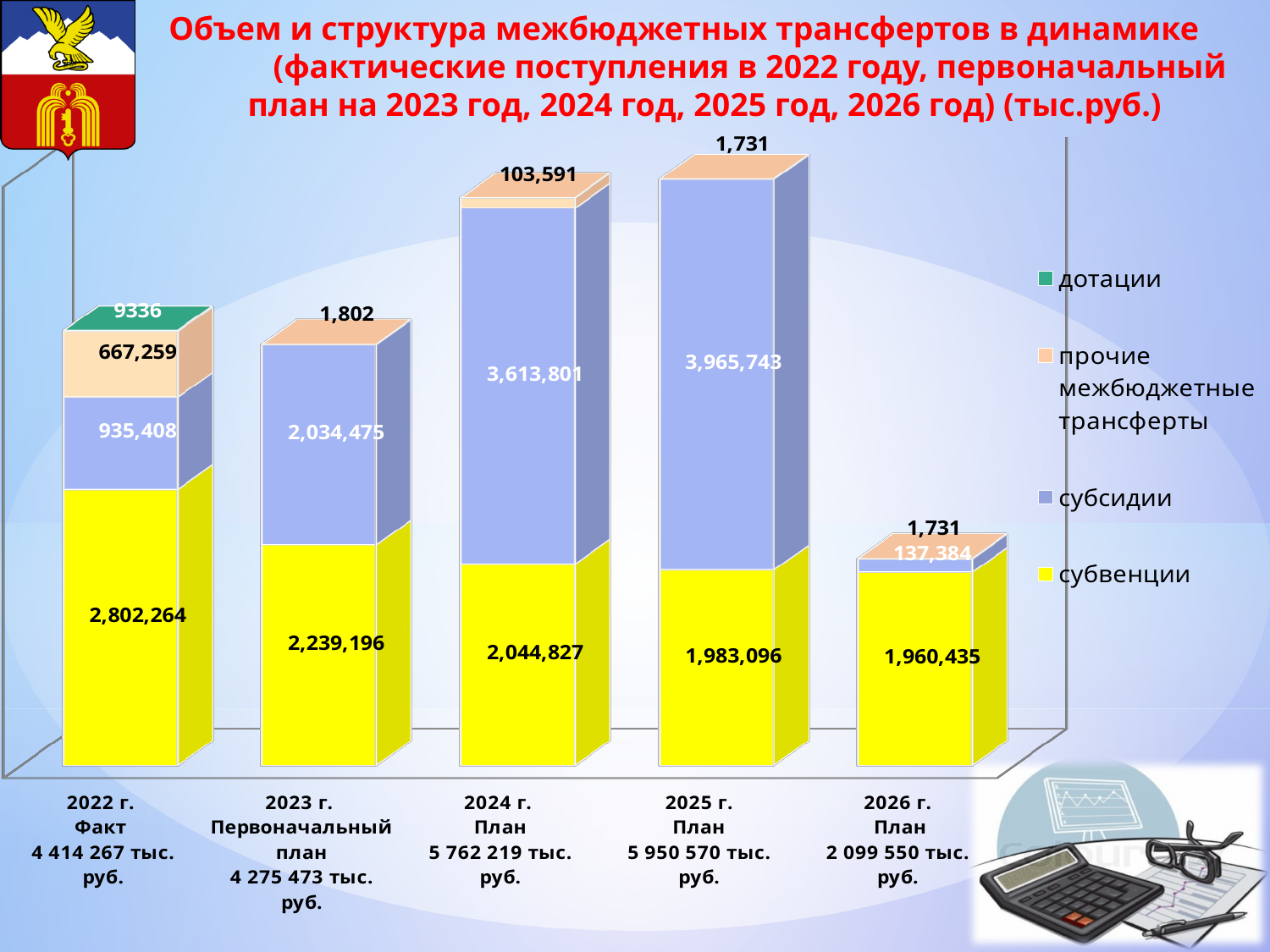
Which year has the highest value of субвенции? 2022 г. Факт What is the value of дотации for 2022 г. Факт? 9336 What is the total of the stacked bar for 2025 г. План? 5 950 570 тыс. руб. What is the difference between субвенции in 2023 г. Первоначальный план and 2024 г. План? 194,369 What is the value of прочие межбюджетные трансферты for 2024 г. План? 103,591 Which year has the lowest value of субсидии? 2026 г. План What kind of chart is shown on the slide? Stacked bar chart What is the value of субвенции for 2022 г. Факт? 2,802,264 Which is larger: субсидии in 2024 г. План or субсидии in 2025 г. План? субсидии in 2025 г. План How many series does the legend list? 4 What is the value of субсидии for 2025 г. План? 3,965,743 How many years (categories) are shown on the x axis? 5